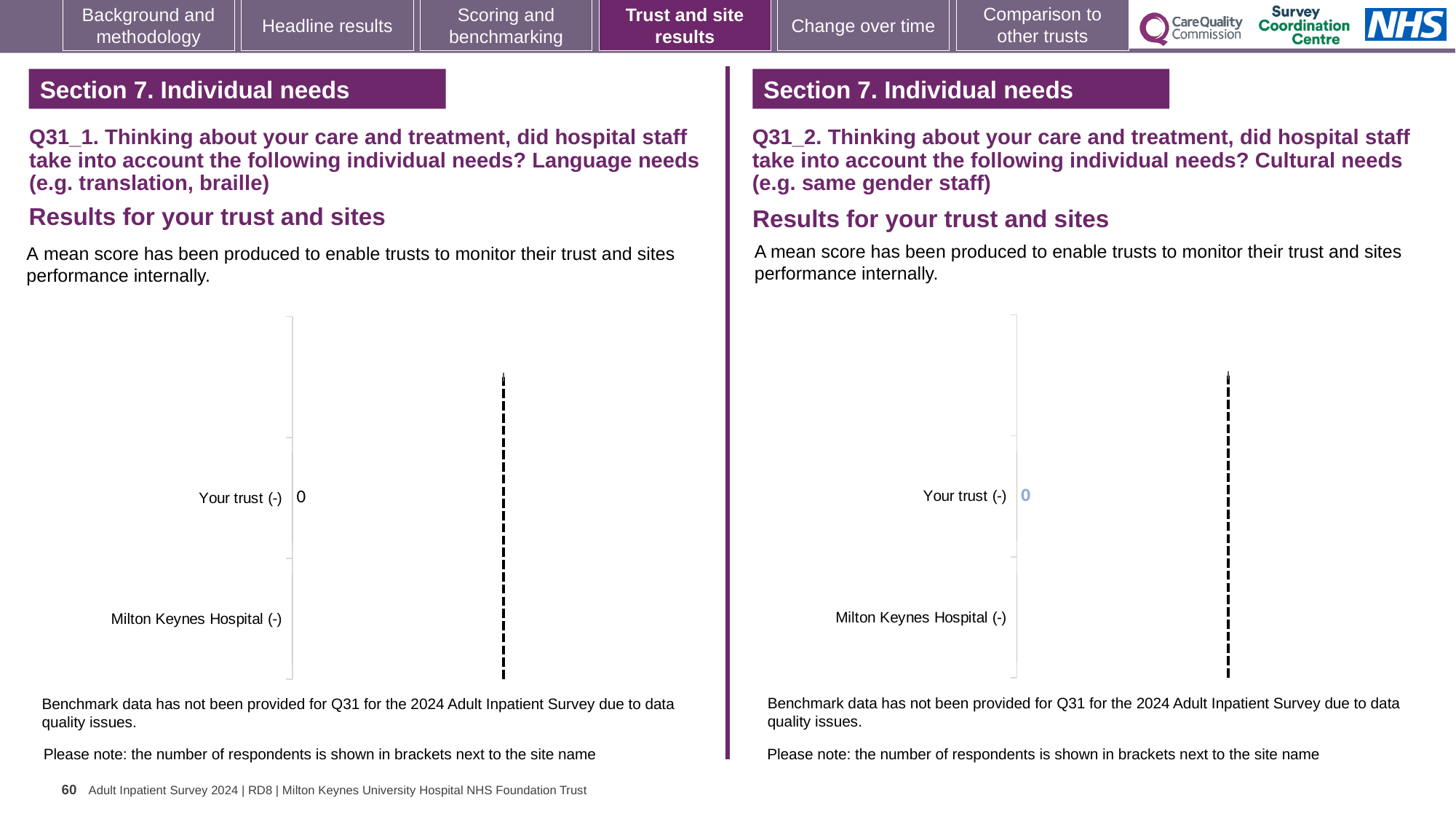
On the right chart (Q31_2, Cultural needs), what value is shown for Your trust (-)? 0 On the left chart (Q31_1, Language needs), what value is shown for Your trust (-)? 0 On the left chart (Q31_1, Language needs), which category is listed below Your trust (-)? Milton Keynes Hospital (-) On the right chart (Q31_2, Cultural needs), how many categories are listed on the vertical axis? 2 What kind of chart is the right chart (Q31_2, Cultural needs)? Bar chart What kind of chart is the left chart (Q31_1, Language needs)? Bar chart On the right chart (Q31_2, Cultural needs), which category is listed first (at the top) on the vertical axis? Your trust (-) On the left chart (Q31_1, Language needs), how many categories are listed on the vertical axis? 2